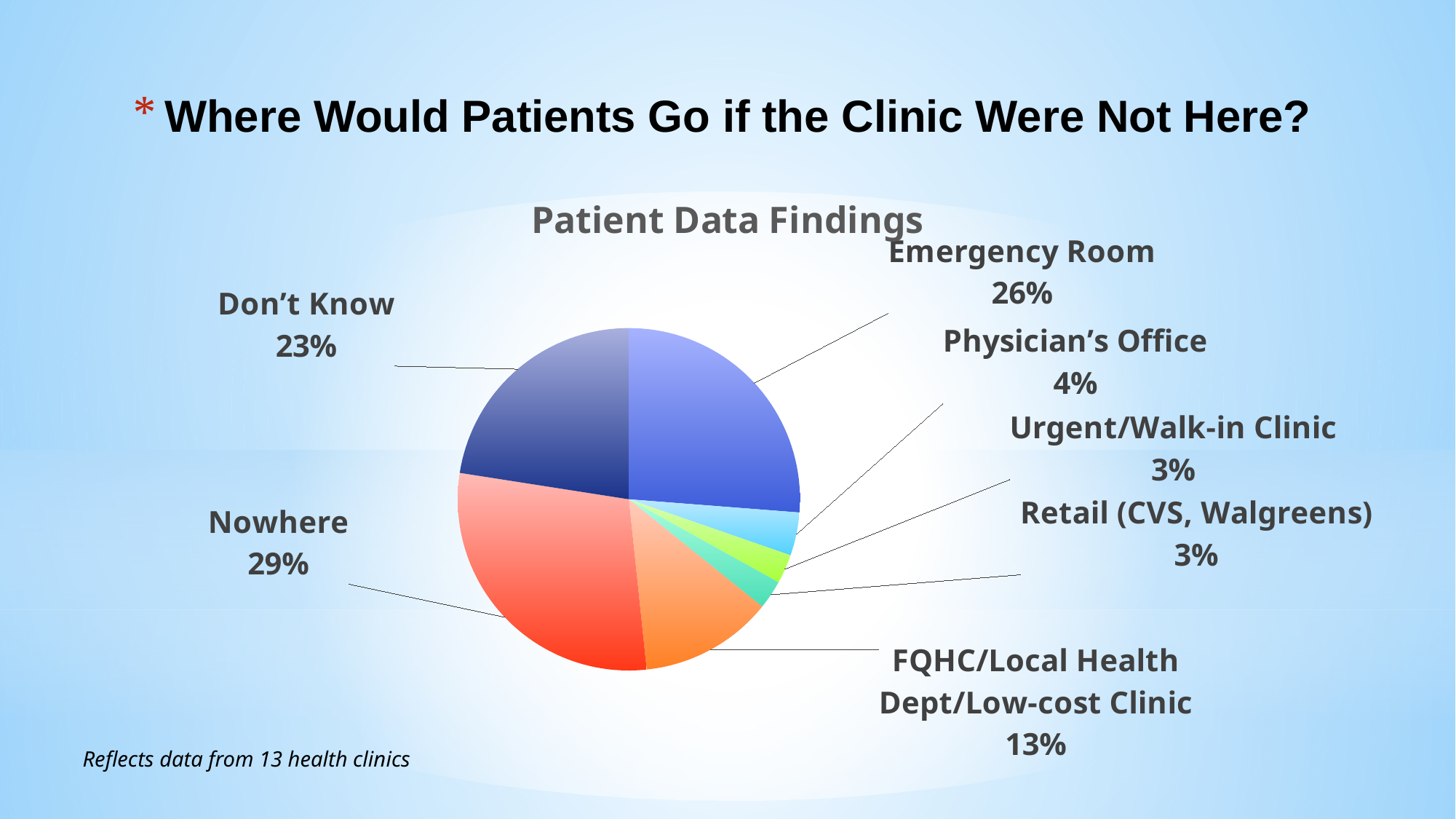
What percentage is shown for FQHC/Local Health Dept/Low-cost Clinic? 13% What is the title of the chart? Patient Data Findings What percentage is shown for Physician's Office? 4% What percentage of patients said they would go to the Emergency Room? 26% What share of the pie is labelled Nowhere? 29% Which category has the largest share of the pie? Nowhere What percentage is shown for Urgent/Walk-in Clinic? 3% Which is larger, the Emergency Room share or the Don't Know share? Emergency Room What is the difference between the Emergency Room share and the FQHC/Local Health Dept/Low-cost Clinic share? 13% How many categories (slices) does the pie chart have? 7 What type of chart is shown on the slide? Pie chart What is the difference between the Nowhere share and the Don't Know share? 6%